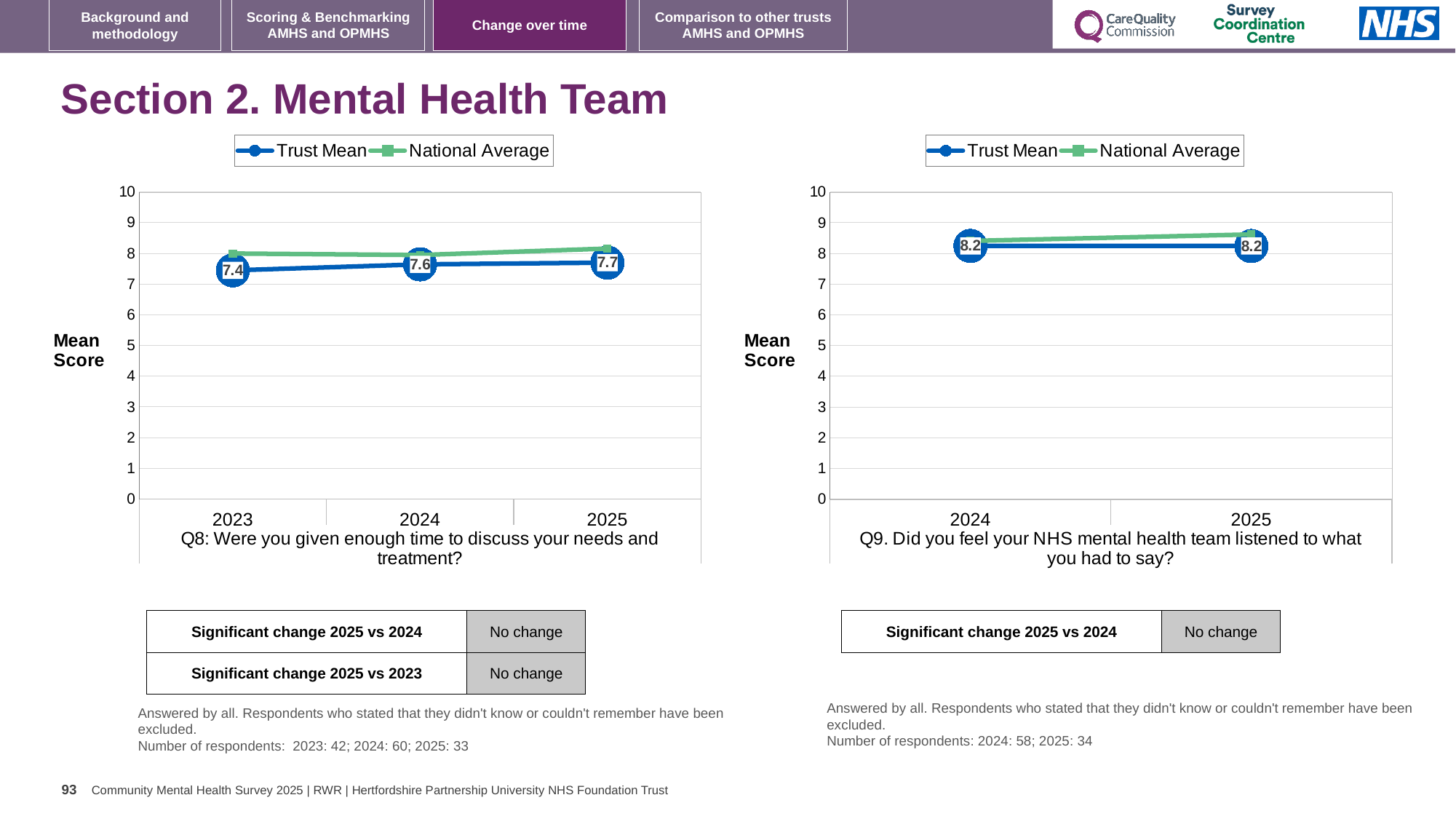
In the Q8 chart on the left, does the Trust Mean rise or fall from 2023 to 2025? Rise How many years are plotted on the x axis of the Q8 chart on the left? 3 In the Q8 chart on the left, what is the Trust Mean for 2023? 7.4 In the Q9 chart on the right, what is the Trust Mean for 2024? 8.2 In the Q9 chart on the right, is the National Average for 2025 greater or less than 8? greater In the Q8 chart on the left, is the Trust Mean for 2024 greater or less than 7? greater In the Q8 chart on the left, which year has the lowest Trust Mean? 2023 How many series does the legend of the Q9 chart on the right list? 2 What kind of chart is the Q8 chart on the left? Line chart In the Q8 chart on the left, which year has the highest Trust Mean? 2025 In the Q8 chart on the left, what is the Trust Mean for 2025? 7.7 In the Q8 chart on the left, what is the difference between the Trust Mean for 2025 and 2023? 0.3